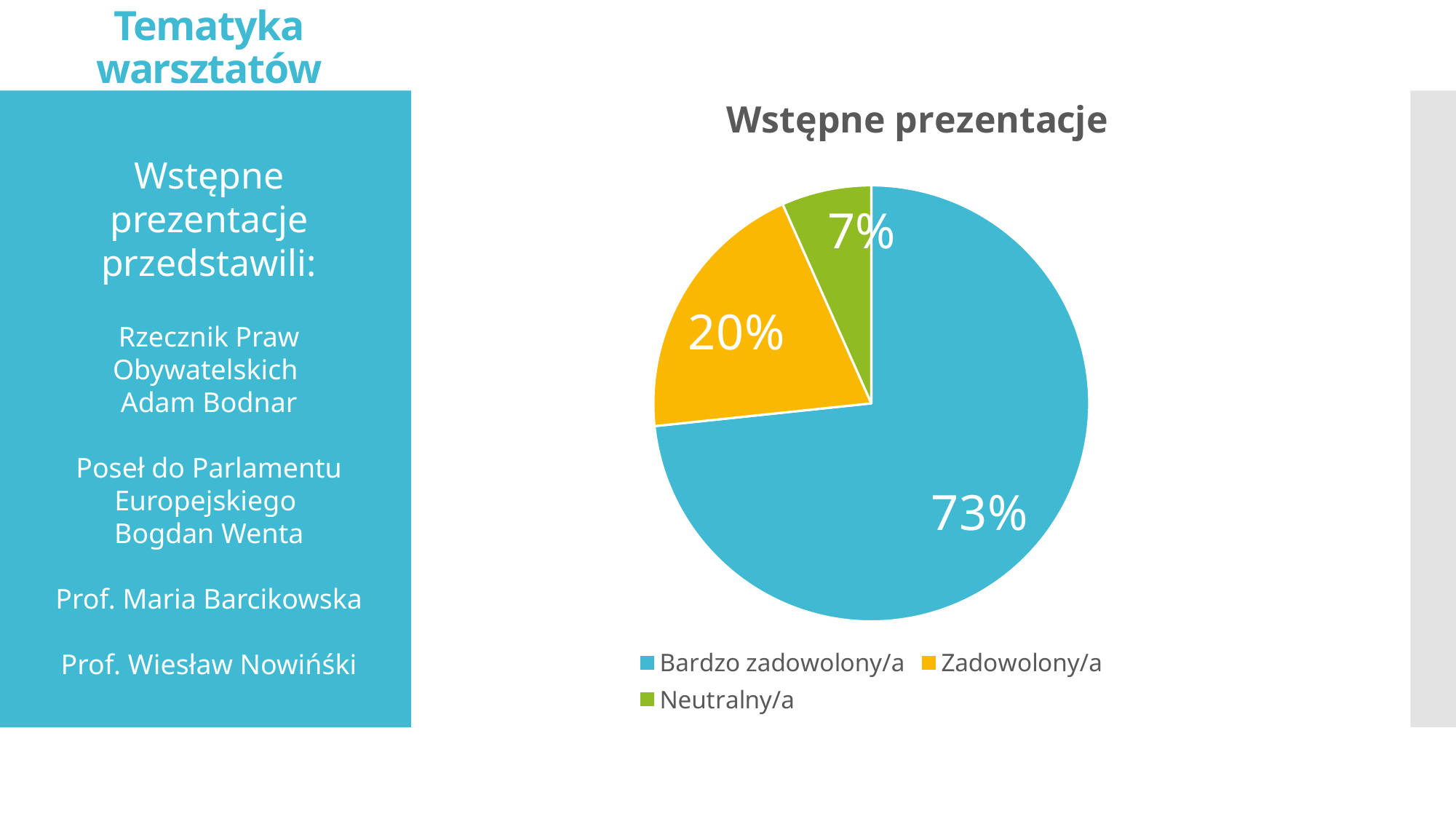
What is the difference in percentage points between "Zadowolony/a" and "Neutralny/a"? 13 What share of the pie is labelled "Neutralny/a"? 7% Which is larger, the slice for "Zadowolony/a" or the slice for "Neutralny/a"? Zadowolony/a What is the title of the chart? Wstępne prezentacje Which category has the largest slice of the pie? Bardzo zadowolony/a How many categories does the legend list? 3 What share of the pie is labelled "Zadowolony/a"? 20% What kind of chart is shown on the slide? pie chart What is the difference in percentage points between "Bardzo zadowolony/a" and "Zadowolony/a"? 53 Which category has the smallest slice of the pie? Neutralny/a What share of the pie is labelled "Bardzo zadowolony/a"? 73% What colour is the slice for "Zadowolony/a"? orange